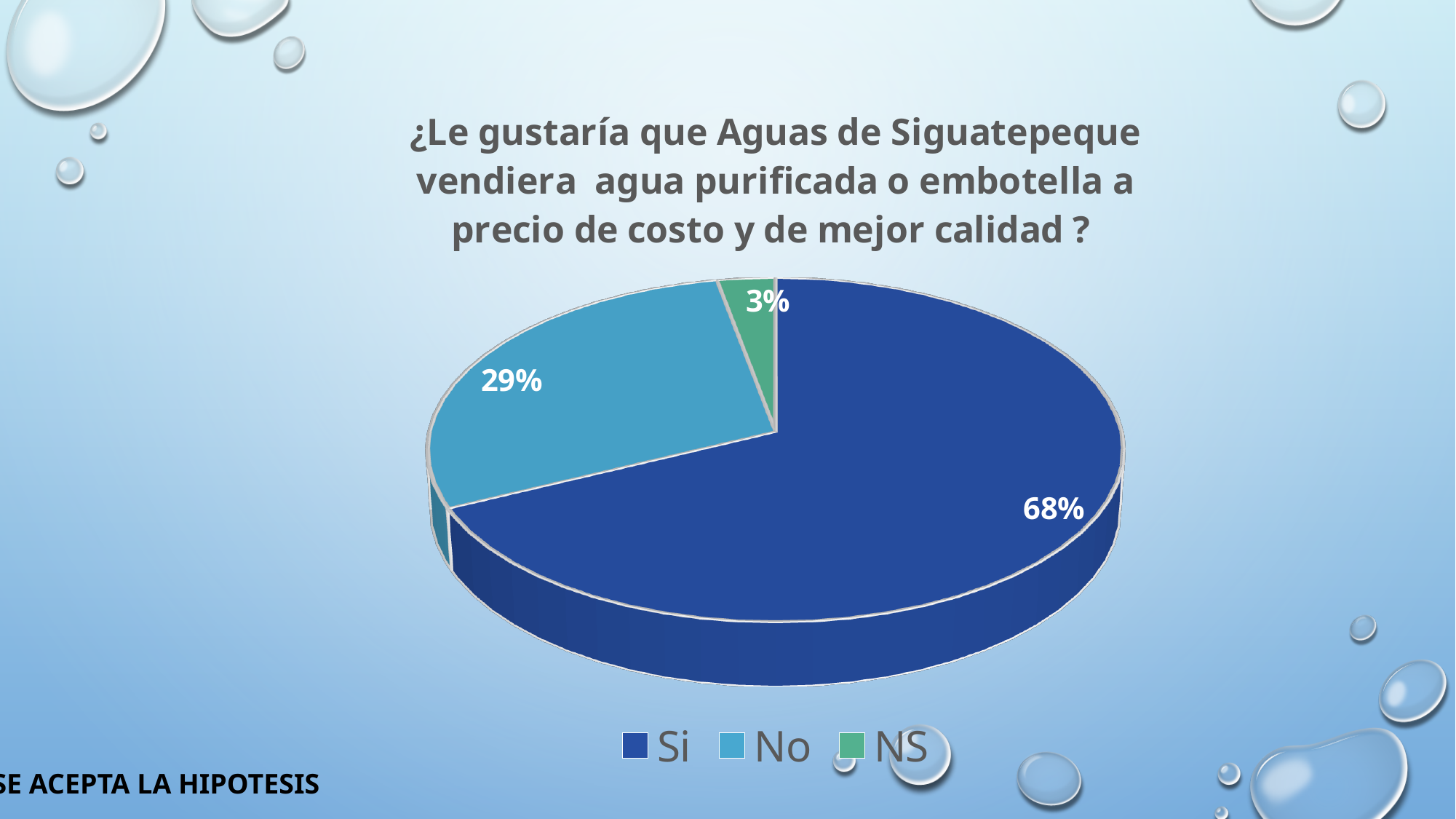
Which response has the smallest share of the pie? NS What kind of chart is shown on the slide? Pie chart What percentage of respondents answered "NS"? 3% What share of the pie does the "Si" slice represent? 68% What is the difference in percentage points between the "No" and "NS" slices? 26 What colour is the "NS" slice in the pie chart? Green Which is larger, the "No" slice or the "NS" slice? No What percentage of respondents answered "No"? 29% How many slices does the pie chart have? 3 What percentage of respondents answered "Si"? 68% What is the difference in percentage points between the "Si" and "No" slices? 39 Which response has the largest share of the pie? Si